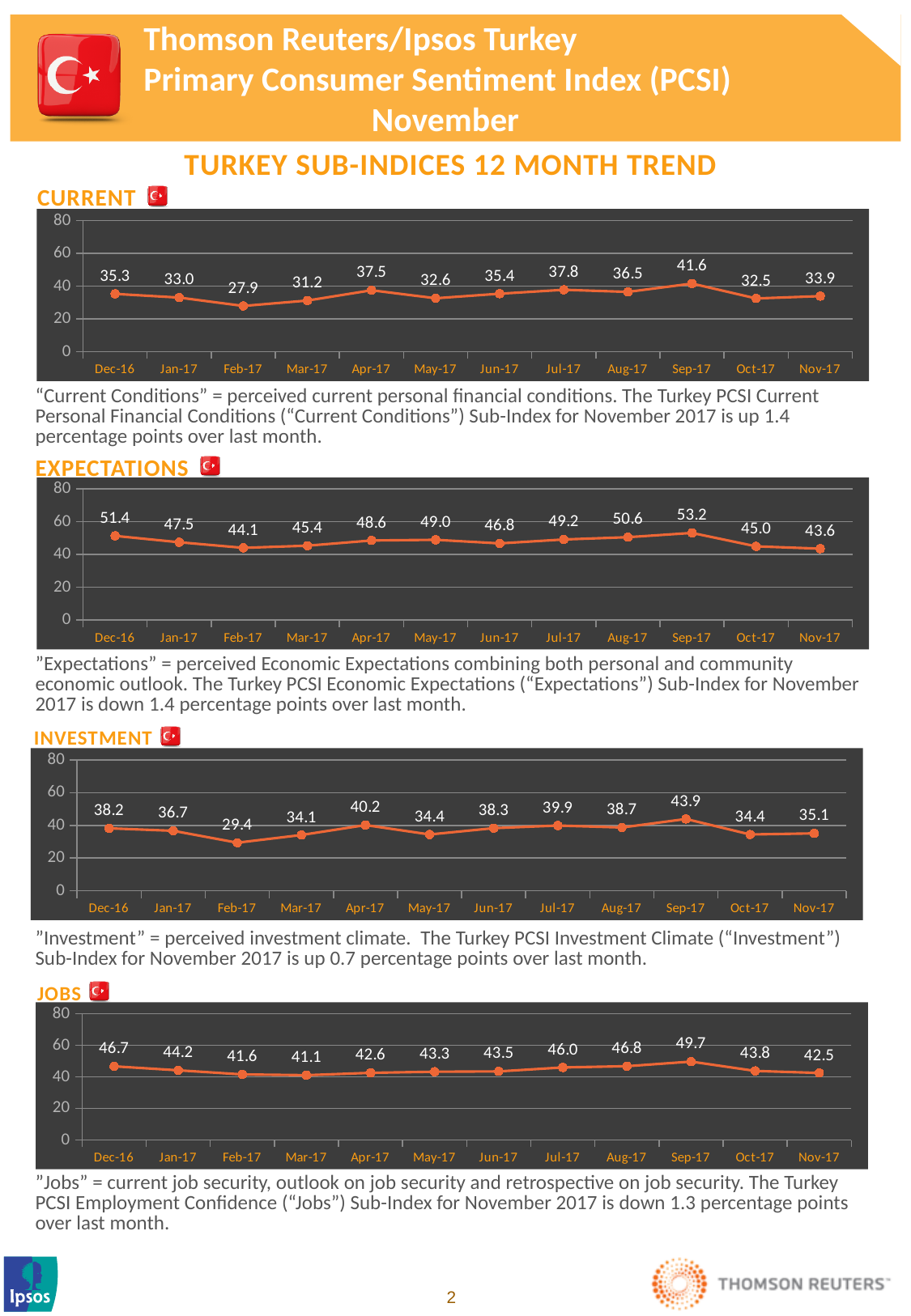
What type of chart is the CURRENT chart? Line chart In the JOBS chart, what is the value for Dec-16? 46.7 In the EXPECTATIONS chart, which month has the highest value? Sep-17 In the CURRENT chart, is the value for Sep-17 greater or less than 40? greater In the CURRENT chart, which month has the lowest value? Feb-17 In the CURRENT chart, what is the value for Sep-17? 41.6 In the INVESTMENT chart, what is the value for Feb-17? 29.4 In the JOBS chart, what is the difference between the Sep-17 and Oct-17 values? 5.9 In the INVESTMENT chart, which is larger, the value for Apr-17 or the value for Jul-17? Apr-17 How many data points are plotted in the JOBS chart? 12 In the EXPECTATIONS chart, what is the difference between the Oct-17 and Nov-17 values? 1.4 In the EXPECTATIONS chart, what is the value for Nov-17? 43.6